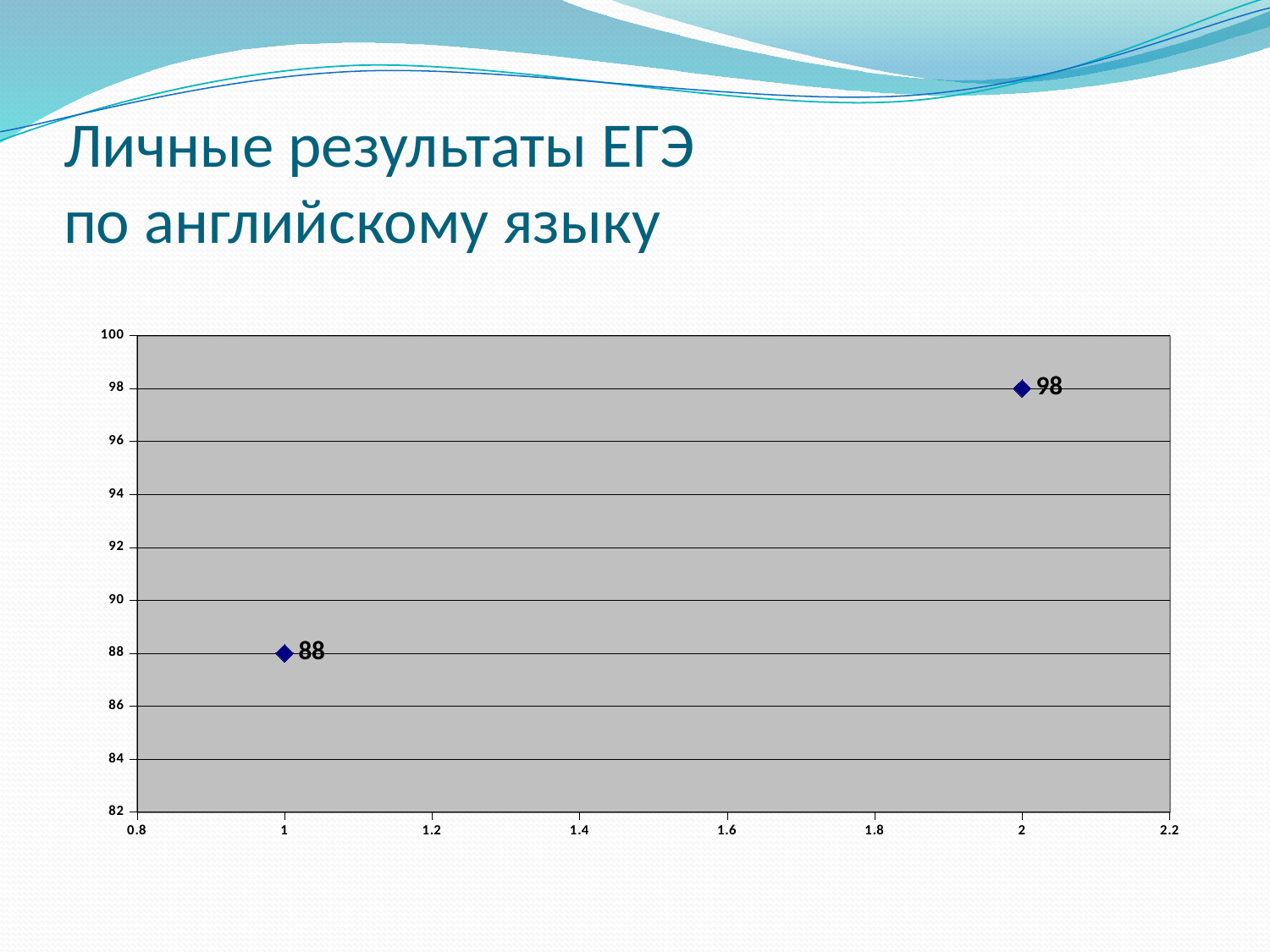
What is the lowest value plotted on the chart? 88 What kind of chart is shown on the slide? scatter chart What is the title of the slide containing the chart? Личные результаты ЕГЭ по английскому языку What is the highest value plotted on the chart? 98 How many data points are plotted on the chart? 2 Do the plotted values rise or fall as x increases from 1 to 2? rise Is the value of the point at x = 2 greater or less than 96? greater What value is labelled on the data point at x = 1? 88 What value is labelled on the data point at x = 2? 98 Is the value of the point at x = 1 greater or less than 90? less What is the difference between the values of the two plotted points? 10 Which data point has the higher value, the one at x = 1 or the one at x = 2? x = 2